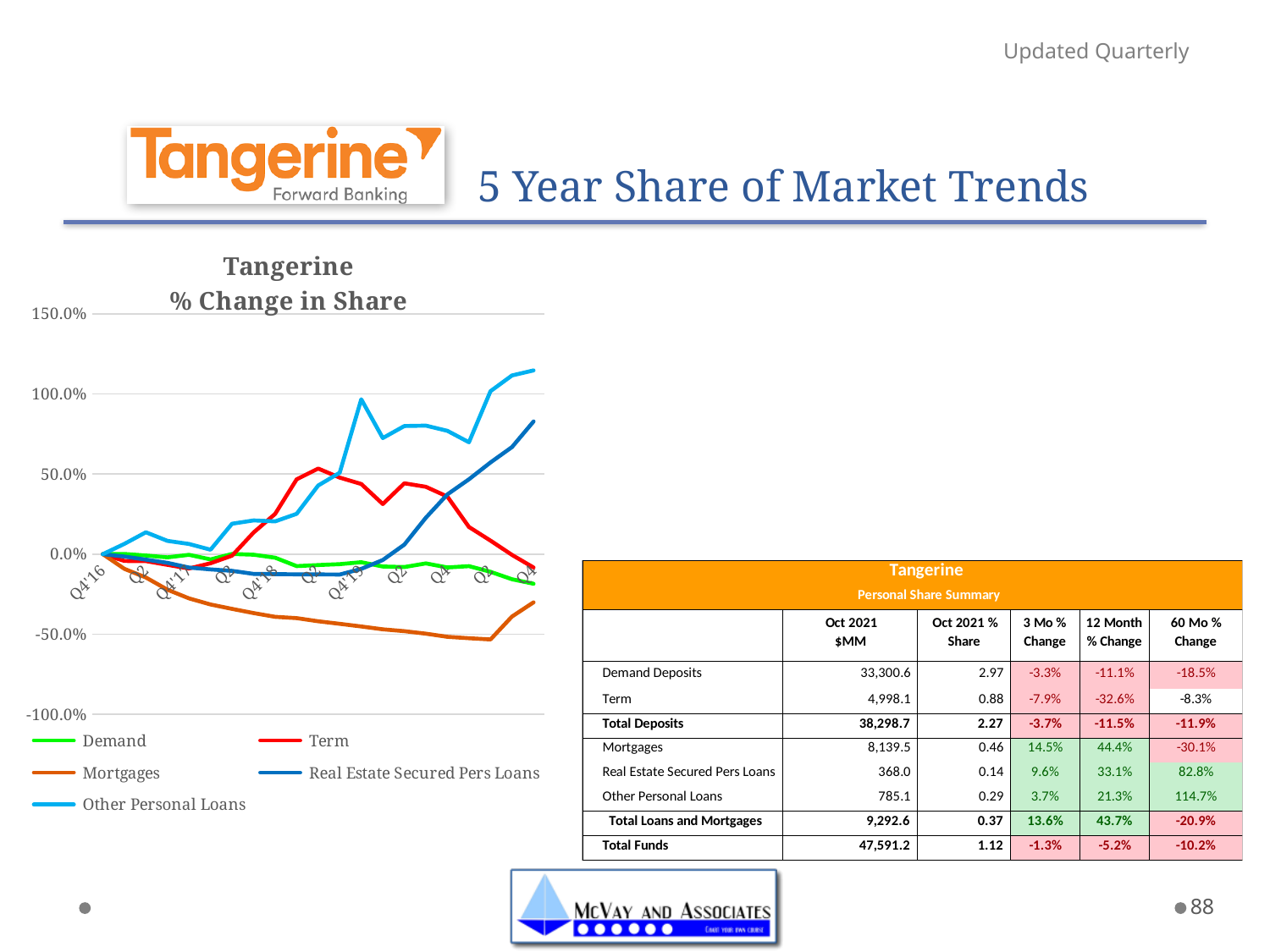
At the right-hand end of the chart, is the value for Other Personal Loans greater or less than 100.0%? greater At the right-hand end of the chart, which is larger: Other Personal Loans or Real Estate Secured Pers Loans? Other Personal Loans Which series is lowest at the right-hand end of the chart? Mortgages Does the Mortgages line generally rise or fall from Q4'16 to Q4'19? fall At the right-hand end of the chart, which is larger: Demand or Mortgages? Demand What kind of chart is shown on the slide? line chart At the right-hand end of the chart, is the value for Real Estate Secured Pers Loans greater or less than 50.0%? greater Which series is highest at the right-hand end of the chart? Other Personal Loans At the right-hand end of the chart, is the value for Mortgages greater or less than 0.0%? less How many series does the legend of the "Tangerine % Change in Share" chart list? 5 Does the Other Personal Loans line generally rise or fall across the period shown? rise What is the title of the chart on the slide? Tangerine % Change in Share